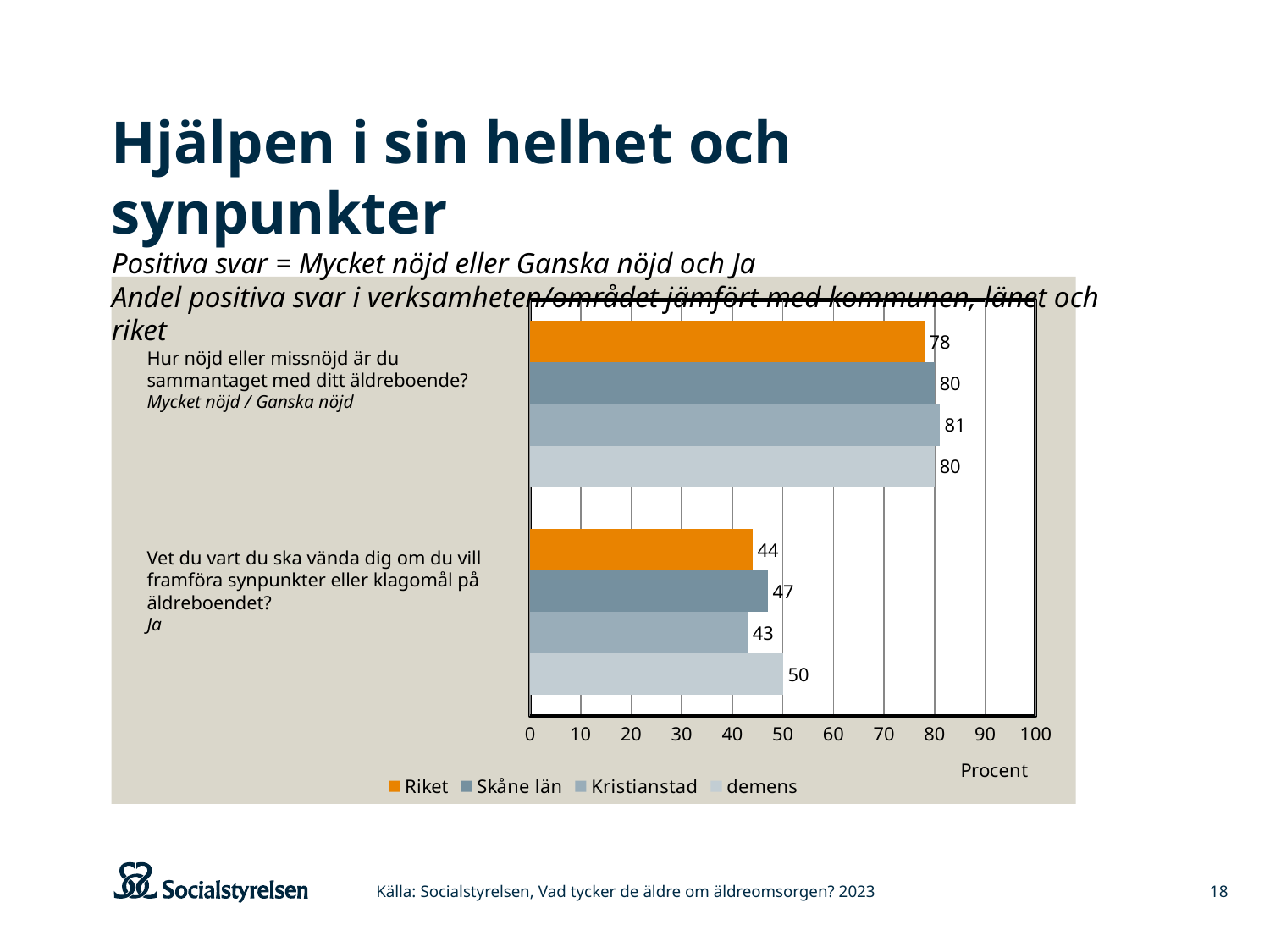
How many series does the legend list? 4 What is the difference between the Kristianstad value and the Riket value on the question "Hur nöjd eller missnöjd är du sammantaget med ditt äldreboende?"? 3 What is the difference between the demens value and the Riket value on the question "Vet du vart du ska vända dig om du vill framföra synpunkter eller klagomål på äldreboendet?"? 6 What is the value for Skåne län on the question "Vet du vart du ska vända dig om du vill framföra synpunkter eller klagomål på äldreboendet?"? 47 What kind of chart is shown on the slide? bar chart What is the value for Riket on the question "Hur nöjd eller missnöjd är du sammantaget med ditt äldreboende?"? 78 Which series has the highest value on the question "Vet du vart du ska vända dig om du vill framföra synpunkter eller klagomål på äldreboendet?"? demens Which series has the lowest value on the question "Vet du vart du ska vända dig om du vill framföra synpunkter eller klagomål på äldreboendet?"? Kristianstad What is the value for Kristianstad on the question "Hur nöjd eller missnöjd är du sammantaget med ditt äldreboende?"? 81 What unit label is shown on the x axis of the chart? Procent What is the value for demens on the question "Vet du vart du ska vända dig om du vill framföra synpunkter eller klagomål på äldreboendet?"? 50 Is the value for Riket on the question "Vet du vart du ska vända dig om du vill framföra synpunkter eller klagomål på äldreboendet?" greater or less than 50? less